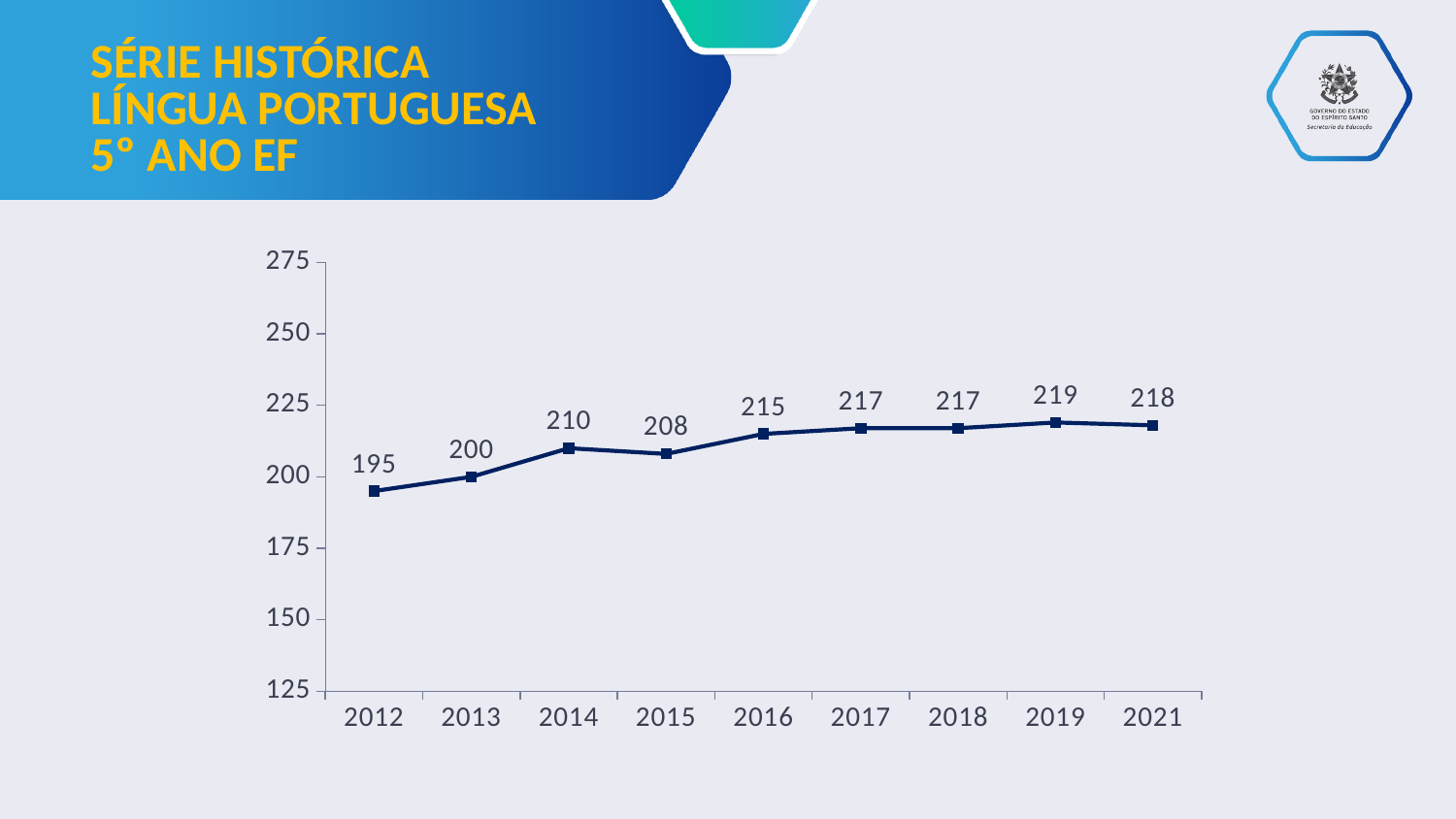
What is the value for 2012? 195 How many years are plotted on the chart? 9 What is the difference between the values for 2019 and 2012? 24 What kind of chart is shown on the slide? line chart What is the value for 2021? 218 Which year has the highest value? 2019 What is the title of the slide? SÉRIE HISTÓRICA LÍNGUA PORTUGUESA 5° ANO EF Do the values generally rise or fall from 2012 to 2021? rise Which is larger, the value for 2014 or the value for 2015? 2014 What is the value for 2016? 215 Is the value for 2013 greater or less than 225? less Which year has the lowest value? 2012